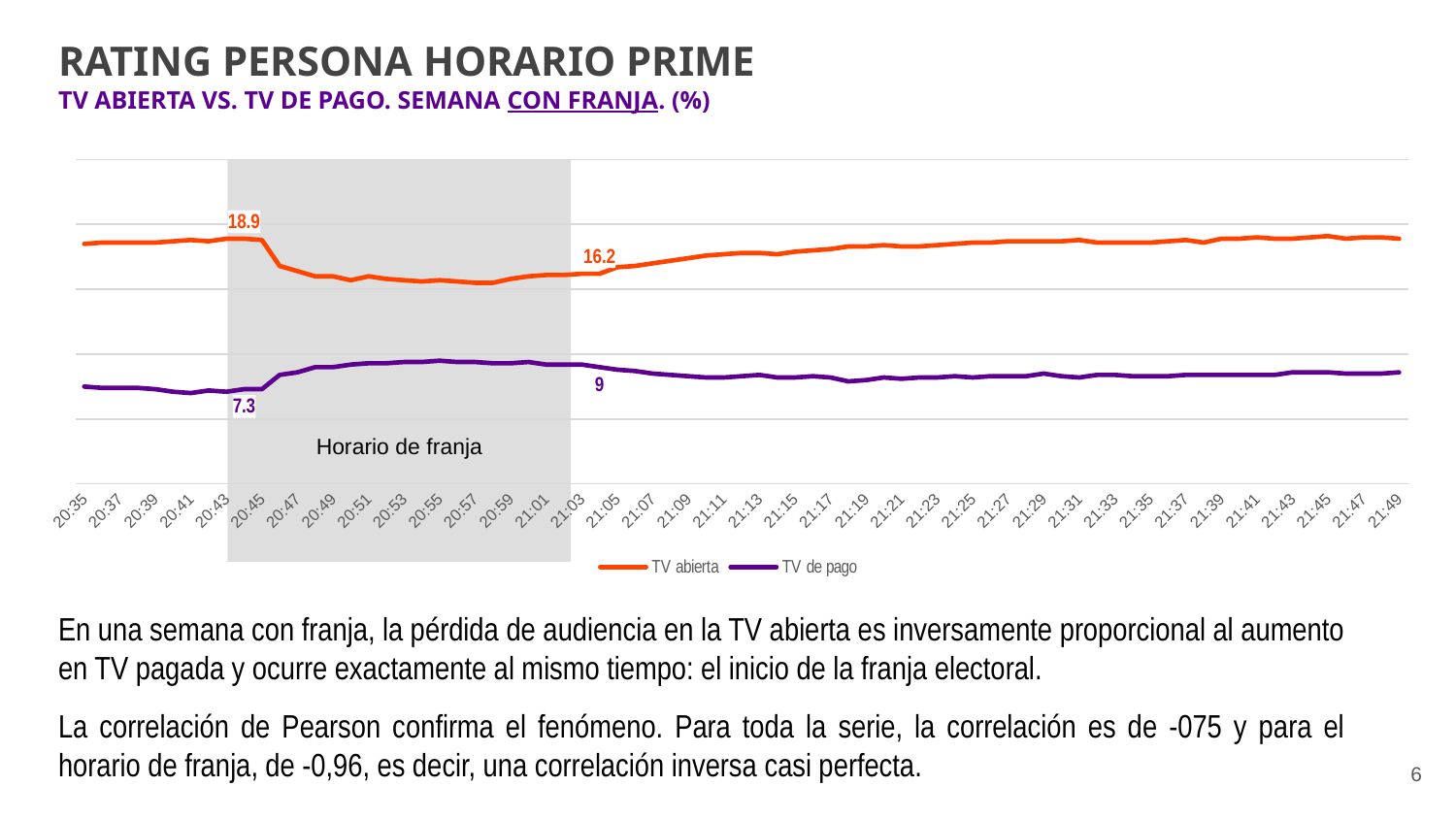
Does the TV abierta line rise or fall during the shaded 'Horario de franja' period? Fall How many series does the legend list? 2 What type of chart is shown on the slide? Line chart What label is shown inside the shaded region of the chart? Horario de franja What is the labelled value for TV de pago at 20:45? 7.3 What is the labelled value for TV abierta at 20:45? 18.9 What is the difference between the TV abierta labels at 20:45 and 21:03? 2.7 At 20:45, which series has the higher value, TV abierta or TV de pago? TV abierta What is the labelled value for TV abierta at 21:03? 16.2 What is the labelled value for TV de pago at 21:03? 9 What is the difference between the TV de pago labels at 21:03 and 20:45? 1.7 Does the TV de pago line rise or fall during the shaded 'Horario de franja' period? Rise